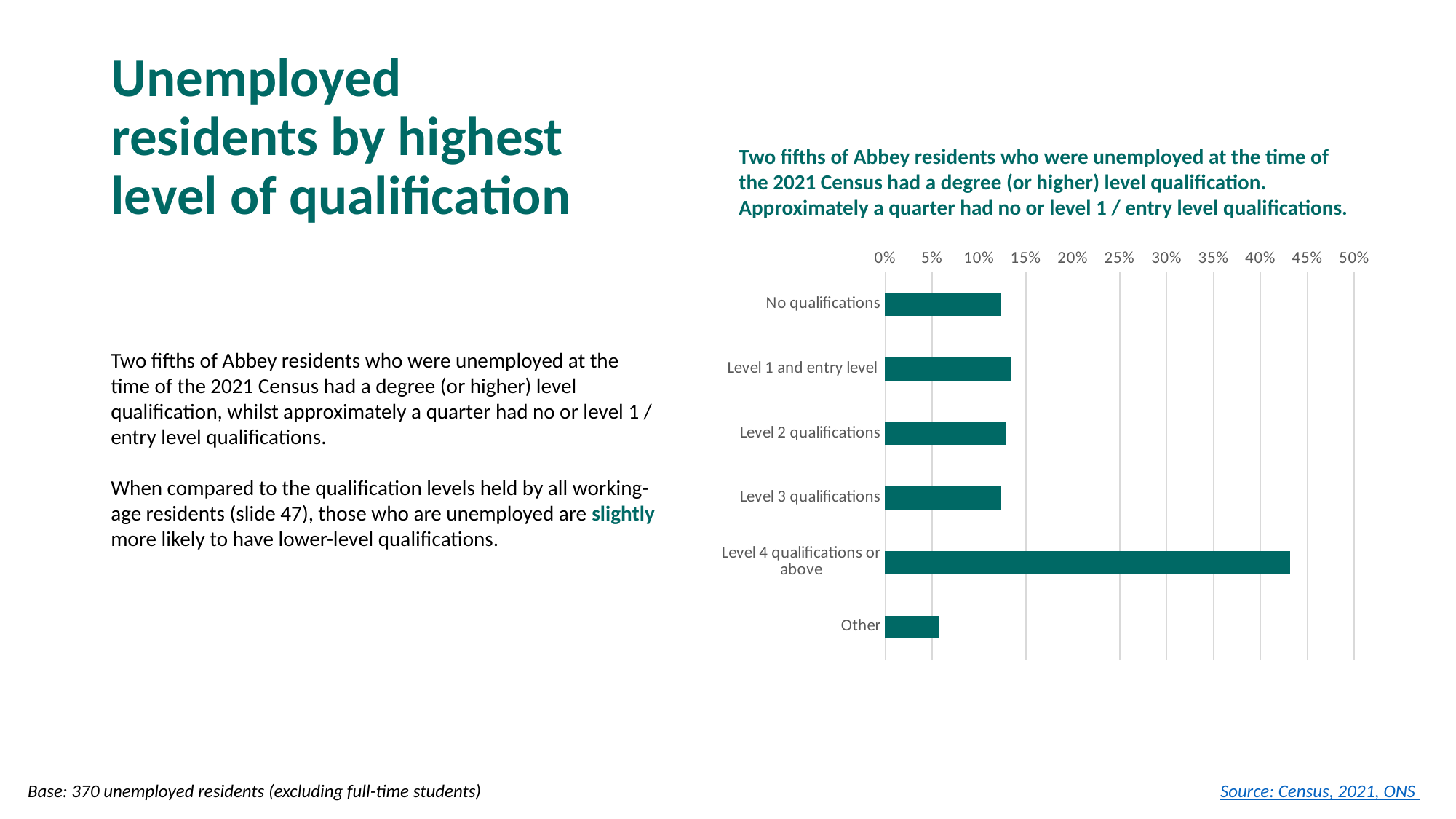
Is the value for Other greater or less than 10%? less Is the value for Level 1 and entry level greater or less than 15%? less Which is larger, the value for Other or the value for Level 3 qualifications? Level 3 qualifications How many qualification categories are plotted in the chart? 6 Which category has the lowest value in the chart? Other What is the highest percentage shown on the chart's horizontal axis? 50% Which category has the highest value in the chart? Level 4 qualifications or above Is the value for No qualifications greater or less than 10%? greater Which is larger, the value for Level 4 qualifications or above or the value for No qualifications? Level 4 qualifications or above What kind of chart is shown on the slide? bar chart